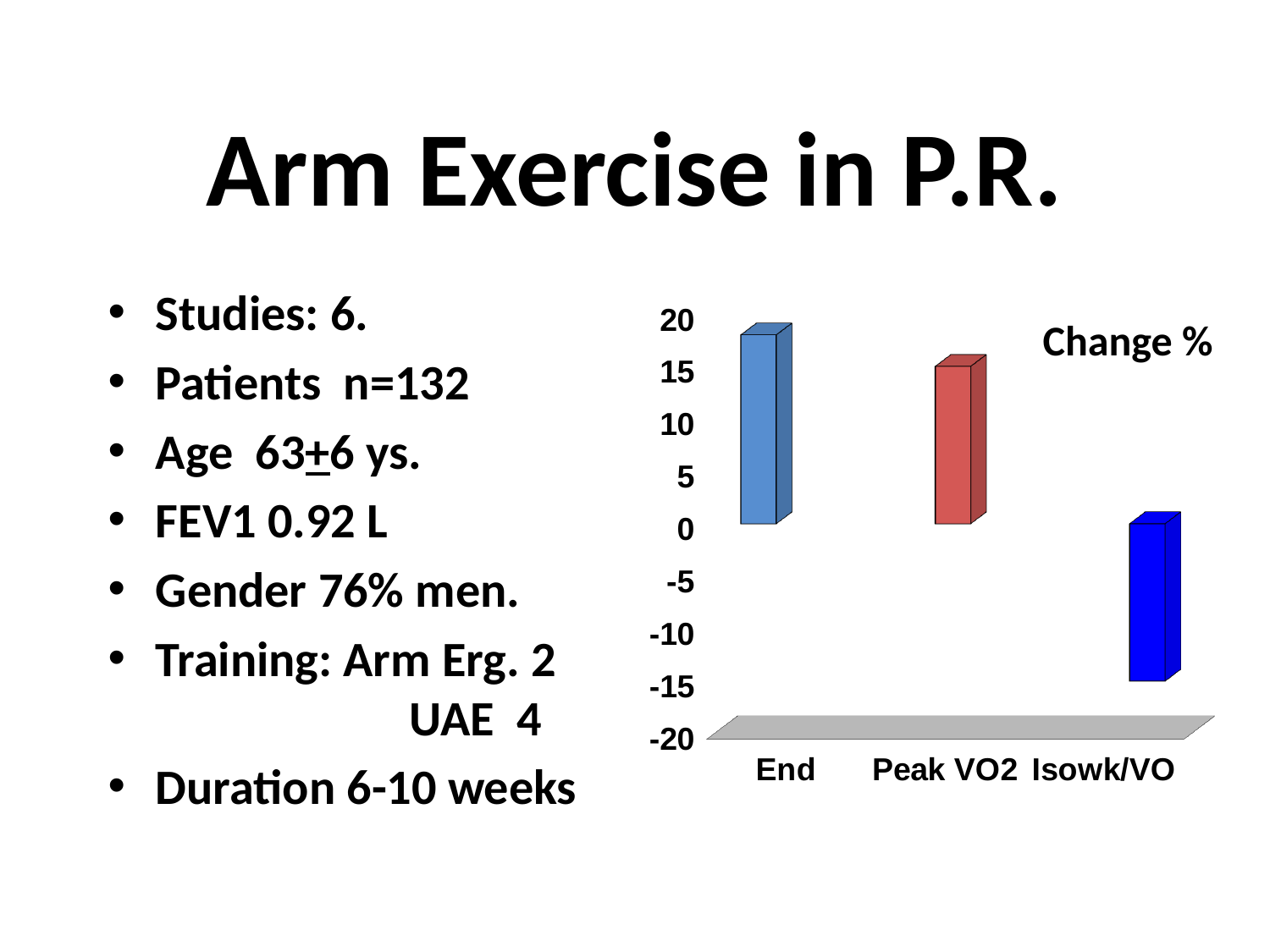
Do the values rise or fall moving from left to right across the categories? fall Is the value for Isowk/VO greater or less than -10? less Which category has the highest value on the chart? End Is the value for Isowk/VO greater or less than 0? less Which is larger, the value for End or the value for Peak VO2? End Which category has the lowest value on the chart? Isowk/VO Which is larger, the value for Peak VO2 or the value for Isowk/VO? Peak VO2 How many categories are plotted on the chart? 3 Is the value for End greater or less than 15? greater What kind of chart is shown on the slide? bar chart What label is shown in the top right corner of the chart indicating what the values represent? Change %